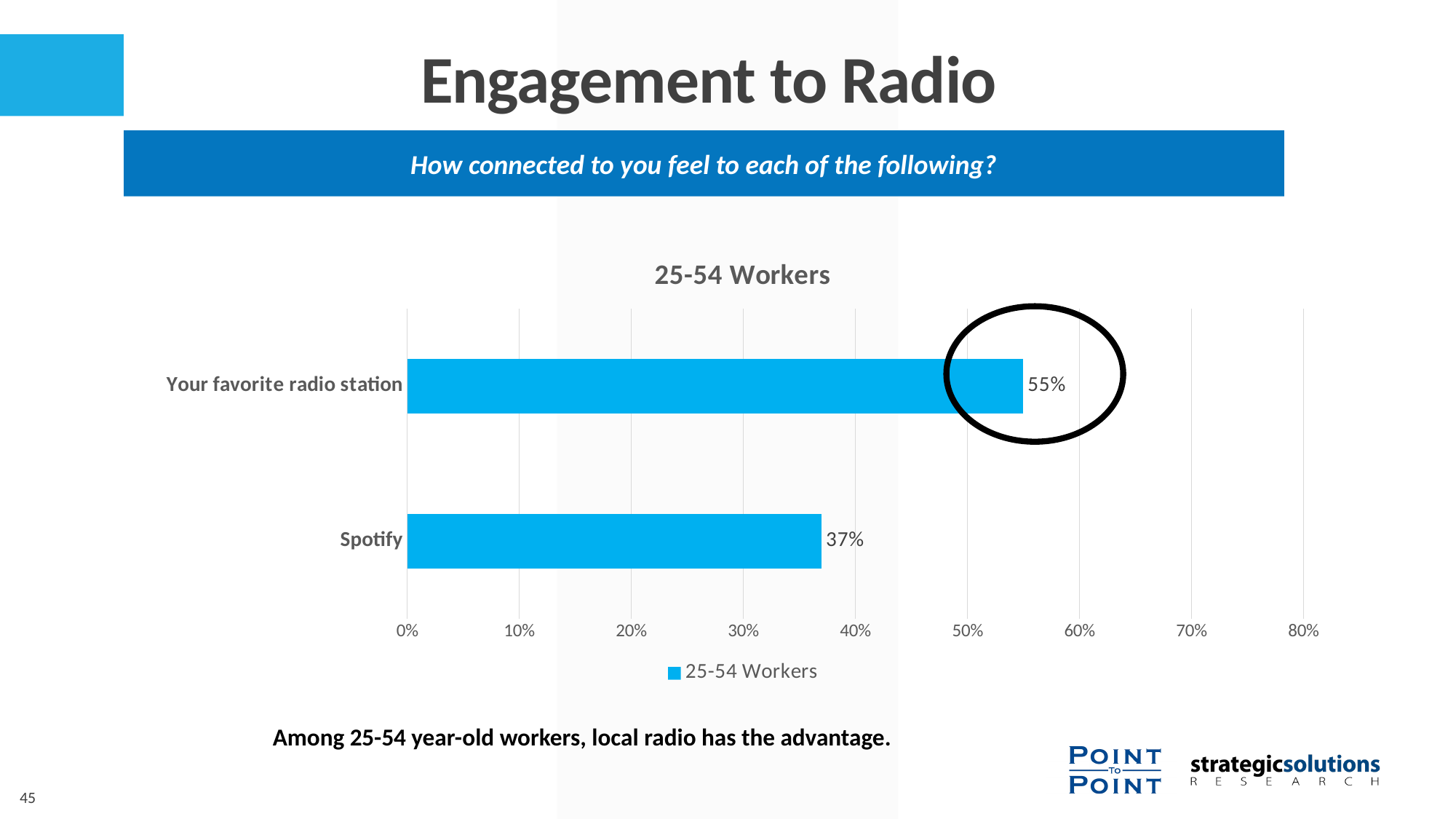
Is the value for Spotify greater or less than 40%? less Which is larger, the value for Spotify or the value for Your favorite radio station? Your favorite radio station What is the value for Your favorite radio station? 55% What kind of chart is shown on the slide? bar chart What is the value for Spotify? 37% What is the title of the chart? 25-54 Workers Which category has the lowest value? Spotify How many series does the legend list? 1 How many categories are shown in the chart? 2 What is the difference between the values for Your favorite radio station and Spotify? 18% Is the value for Your favorite radio station greater or less than 50%? greater Which category has the highest value? Your favorite radio station